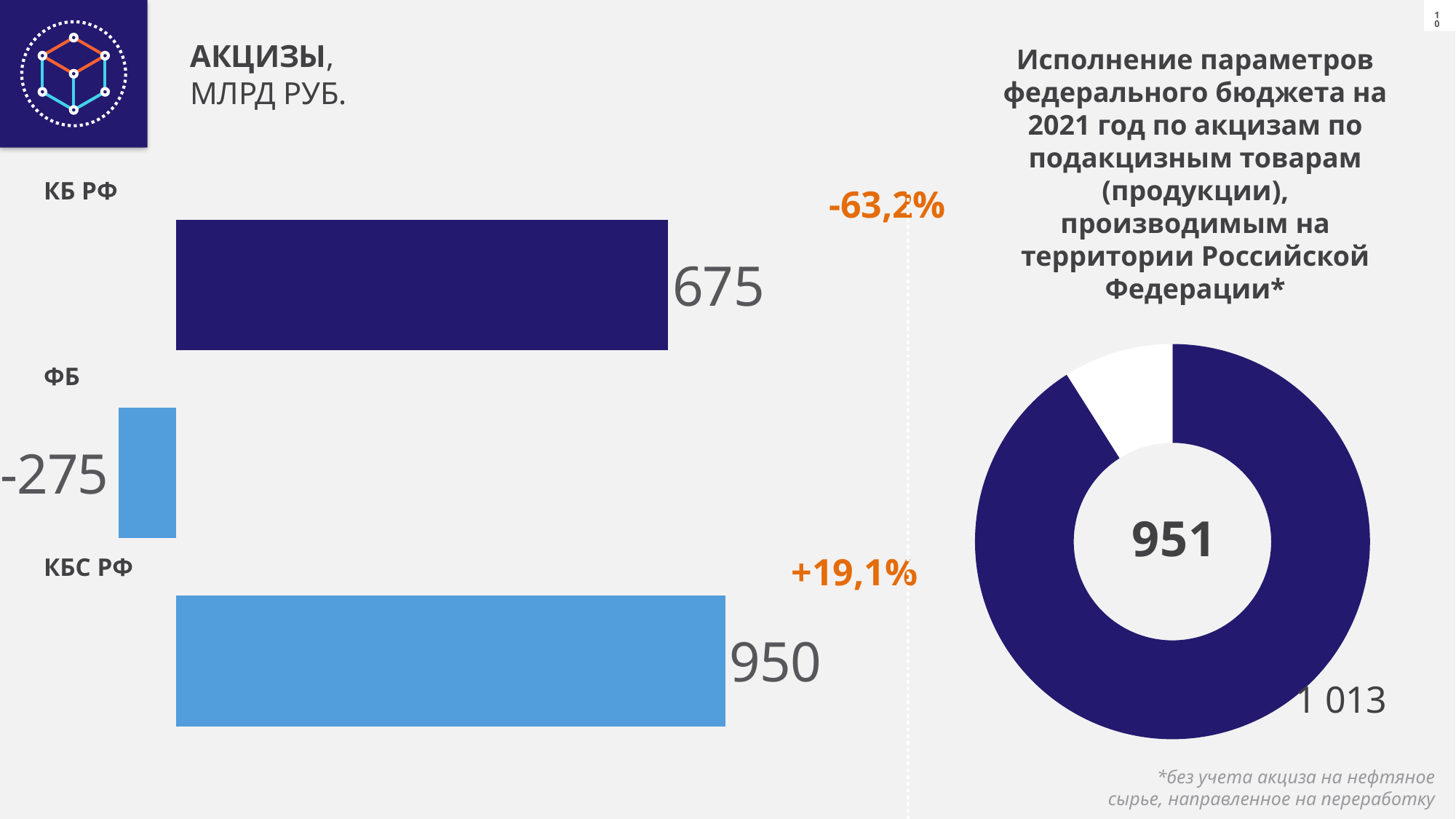
On the bar chart 'АКЦИЗЫ, МЛРД РУБ.', what percentage change is shown next to the КБС РФ bar? +19,1% What value is printed in the centre of the donut chart on the right of the slide? 951 On the bar chart 'АКЦИЗЫ, МЛРД РУБ.', which category has the highest value? КБС РФ On the bar chart 'АКЦИЗЫ, МЛРД РУБ.', what is the difference between the values for КБС РФ and КБ РФ? 275 What kind of chart is the chart on the left of the slide titled 'АКЦИЗЫ, МЛРД РУБ.'? Bar chart How many categories are shown on the bar chart 'АКЦИЗЫ, МЛРД РУБ.'? 3 On the bar chart 'АКЦИЗЫ, МЛРД РУБ.', what percentage change is shown next to the КБ РФ bar? -63,2% On the bar chart 'АКЦИЗЫ, МЛРД РУБ.', which category has the lowest value? ФБ On the bar chart 'АКЦИЗЫ, МЛРД РУБ.', what is the value for ФБ? -275 On the bar chart 'АКЦИЗЫ, МЛРД РУБ.', what is the value for КБ РФ? 675 On the bar chart 'АКЦИЗЫ, МЛРД РУБ.', which is larger, the value for КБ РФ or the value for КБС РФ? КБС РФ On the bar chart 'АКЦИЗЫ, МЛРД РУБ.', what is the value for КБС РФ? 950